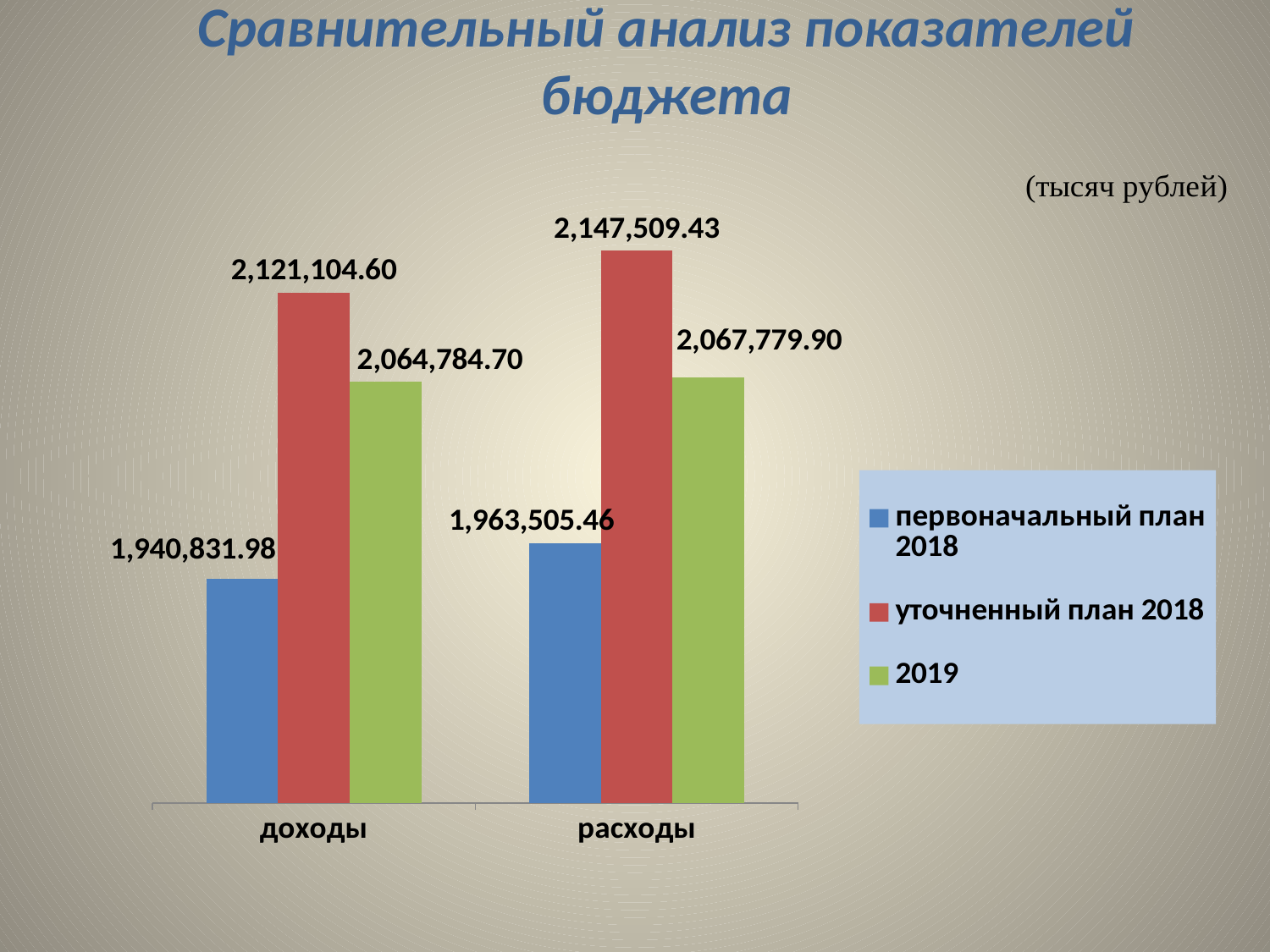
Which is larger: the 2019 value for доходы or the 2019 value for расходы? расходы What is the value of the 2019 series for расходы? 2,067,779.90 What is the difference between the уточненный план 2018 and первоначальный план 2018 values for доходы? 180,272.62 What kind of chart is shown on the slide? bar chart What is the value of the первоначальный план 2018 series for расходы? 1,963,505.46 Which series has the highest value for расходы? уточненный план 2018 What is the value of the уточненный план 2018 series for доходы? 2,121,104.60 What is the value of the первоначальный план 2018 series for доходы? 1,940,831.98 Which series has the lowest value for доходы? первоначальный план 2018 How many series does the legend list? 3 How many categories are shown on the x axis? 2 What is the difference between the уточненный план 2018 values for расходы and доходы? 26,404.83